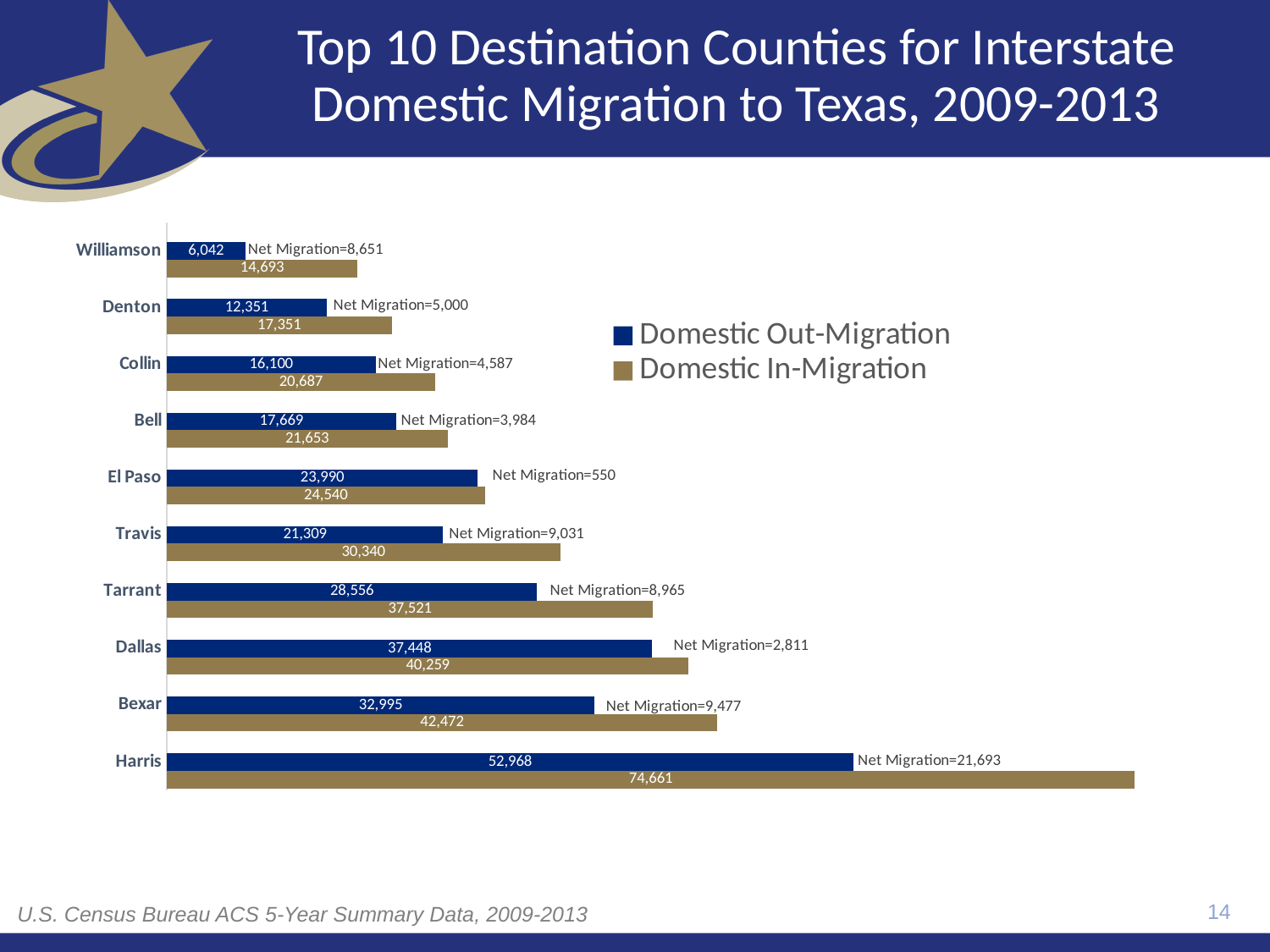
What kind of chart is shown on the slide? Bar chart What is the Domestic In-Migration value for Harris? 74,661 Which county has the highest Domestic In-Migration value? Harris Which is larger: the Domestic In-Migration value for Bexar or for Dallas? Bexar Which county has the lowest Domestic Out-Migration value? Williamson What net migration figure is shown next to the bars for Travis? Net Migration=9,031 What is the Domestic Out-Migration value for Bexar? 32,995 How many counties are shown in the chart? 10 What is the difference between Domestic In-Migration and Domestic Out-Migration for Tarrant? 8,965 Which series is shown in blue according to the legend? Domestic Out-Migration What is the Domestic In-Migration value for Travis? 30,340 How many series does the legend list? 2